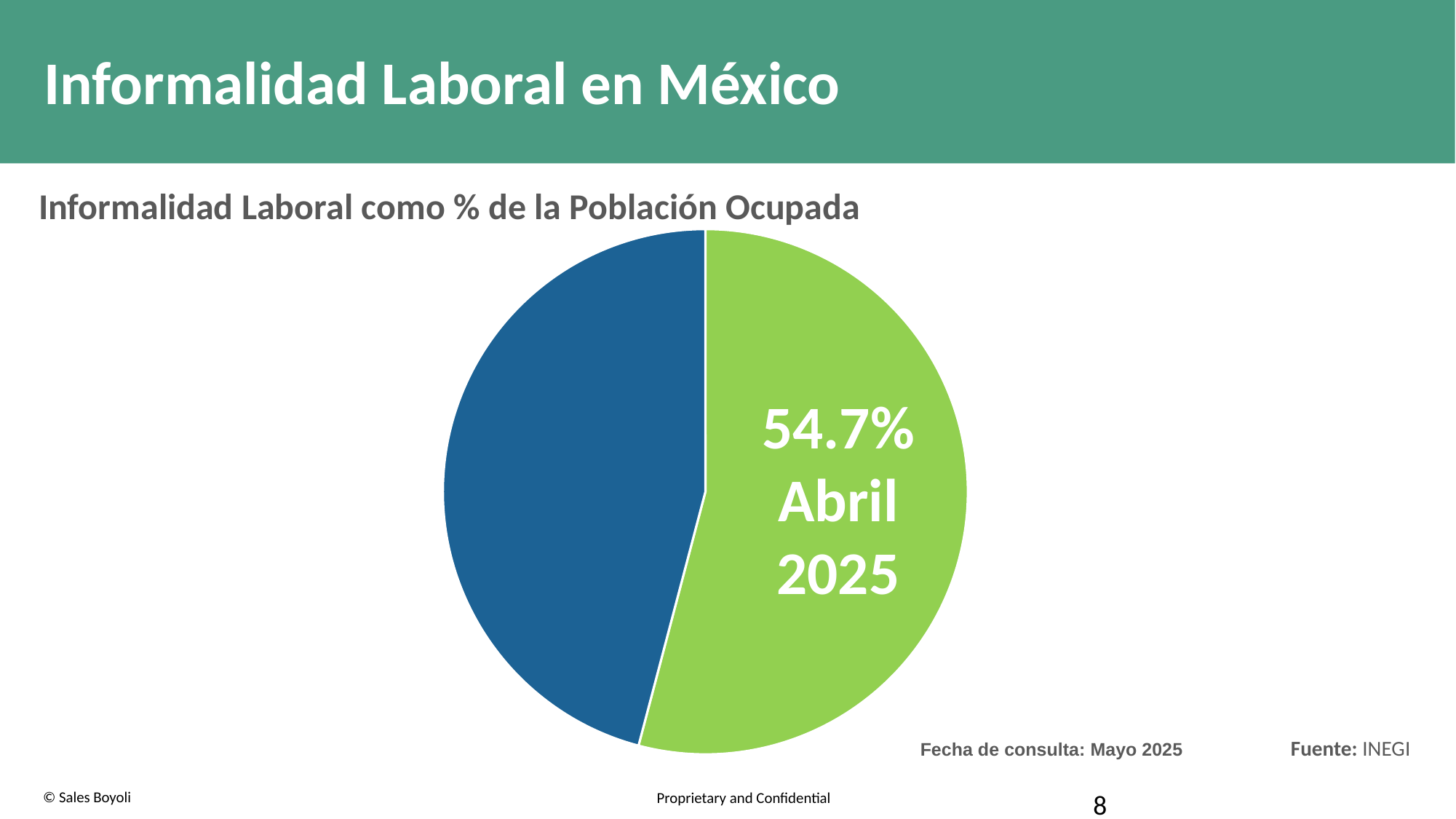
Is the value of the green slice greater or less than 50%? greater What kind of chart is shown on the slide? Pie chart Which slice of the pie chart is larger, the green one or the blue one? The green one What value is printed on the green slice of the pie chart? 54.7% What is the title of the chart? Informalidad Laboral como % de la Población Ocupada What share of the pie does the slice labelled Abril 2025 represent? 54.7% What colour is the slice that carries the 54.7% label? Green Which month and year is printed on the labelled slice of the pie chart? Abril 2025 How many slices does the pie chart have? 2